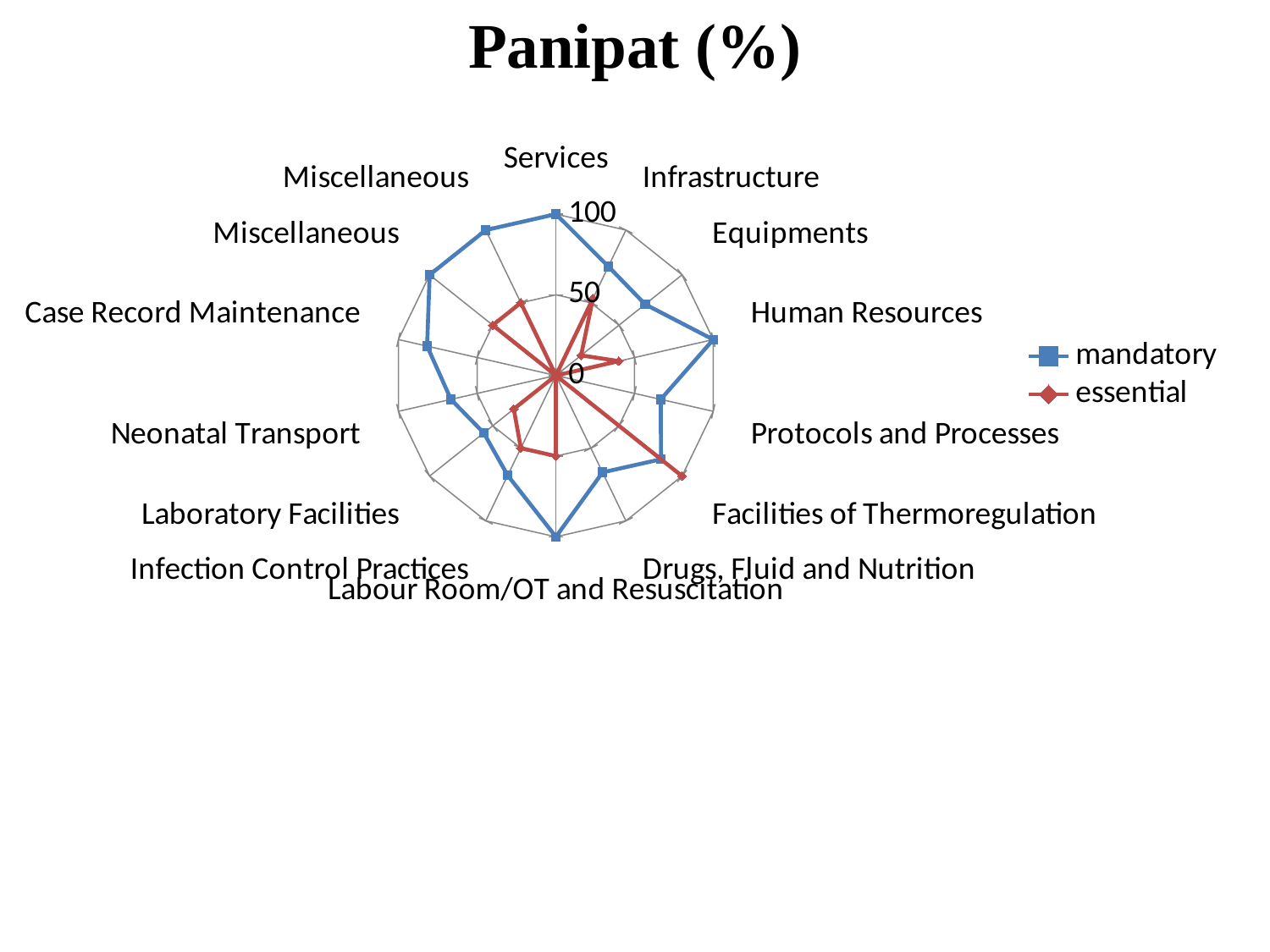
Is the mandatory value for Infrastructure greater or less than 50? greater What is the title of the chart? Panipat (%) For Services, which series has the larger value, mandatory or essential? mandatory Is the essential value for Facilities of Thermoregulation greater or less than 50? greater What is the mandatory value for Services? 100 How many series does the legend list? 2 Is the essential value for Services greater or less than 50? less Which colour represents the essential series in the legend? Red How many categories are plotted around the radar chart? 14 What kind of chart is shown on the slide? Radar chart Which category has the highest essential value? Facilities of Thermoregulation